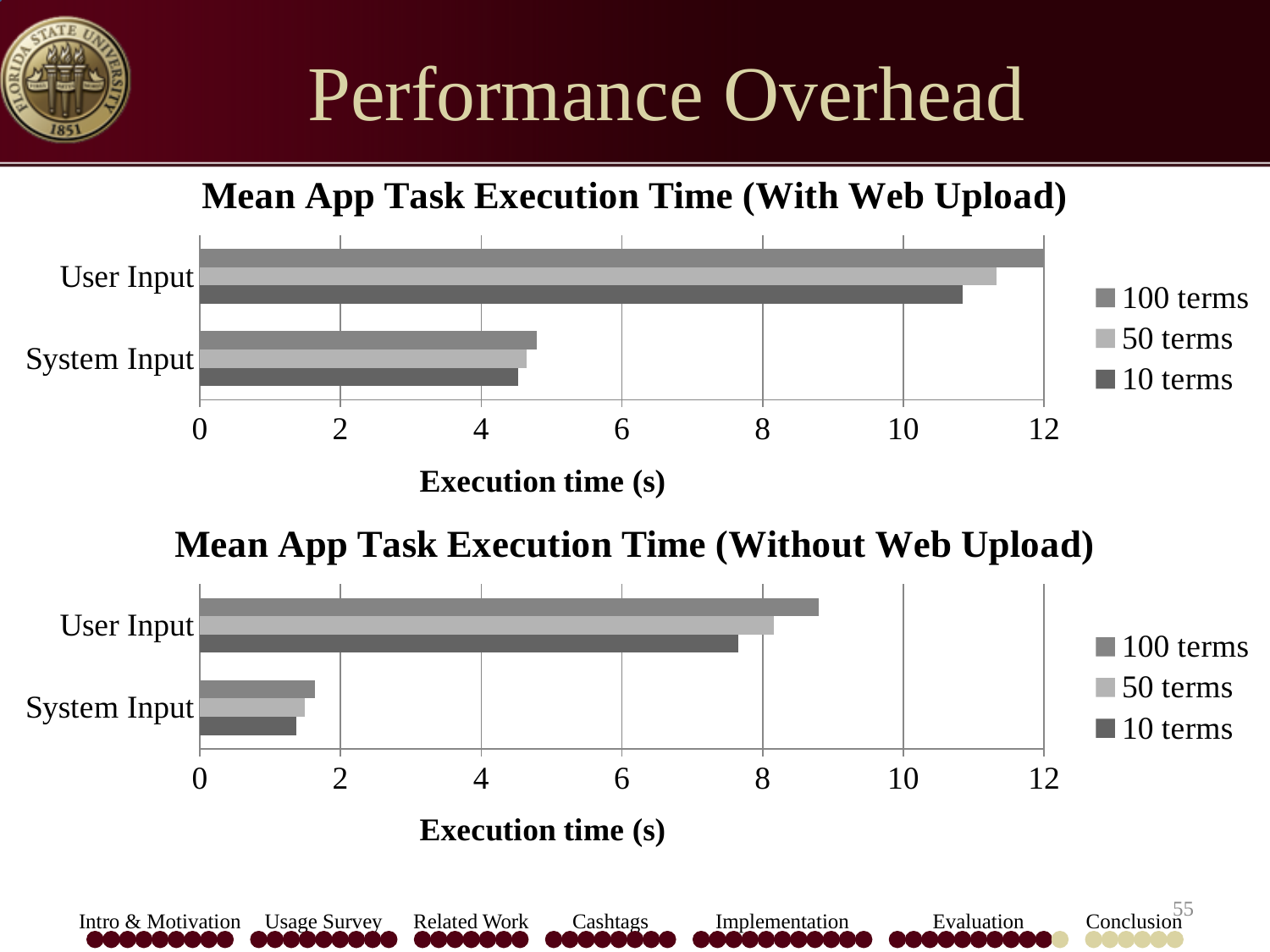
What kind of chart is the 'Mean App Task Execution Time (With Web Upload)' chart? bar chart In the 'Mean App Task Execution Time (Without Web Upload)' chart, which series has the longest bar for User Input? 100 terms In the 'Mean App Task Execution Time (Without Web Upload)' chart, is the value for User Input with 100 terms greater or less than 8? greater In the 'Mean App Task Execution Time (With Web Upload)' chart, is the value for User Input with 100 terms greater or less than 10? greater What is the title of the lower chart on the slide? Mean App Task Execution Time (Without Web Upload) In the 'Mean App Task Execution Time (With Web Upload)' chart, which category has the higher execution time, User Input or System Input? User Input How many categories are shown on the y axis of the 'Mean App Task Execution Time (With Web Upload)' chart? 2 In the 'Mean App Task Execution Time (With Web Upload)' chart, is the value for System Input with 10 terms greater or less than 6? less In the 'Mean App Task Execution Time (Without Web Upload)' chart, which category has the lowest execution time? System Input How many series does the legend of the 'Mean App Task Execution Time (Without Web Upload)' chart list? 3 What is the x-axis label of the 'Mean App Task Execution Time (With Web Upload)' chart? Execution time (s)